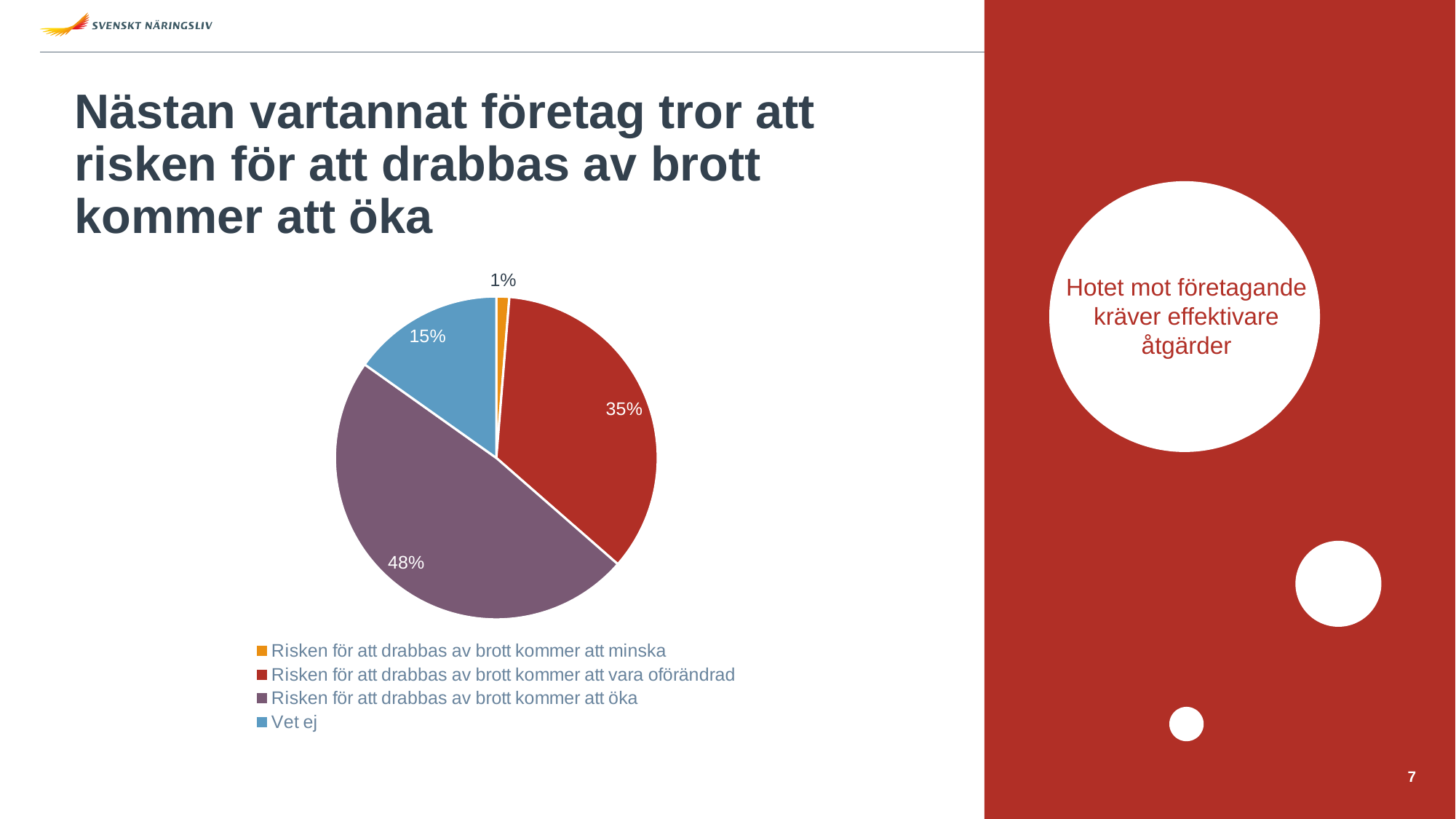
How many slices does the pie chart have? 4 What kind of chart is shown on the slide? pie chart What share of the pie is 'Vet ej'? 15% What share of the pie is 'Risken för att drabbas av brott kommer att minska'? 1% Which is larger: the share for 'Vet ej' or the share for 'Risken för att drabbas av brott kommer att vara oförändrad'? Risken för att drabbas av brott kommer att vara oförändrad What is the difference in percentage points between 'Risken för att drabbas av brott kommer att öka' and 'Risken för att drabbas av brott kommer att vara oförändrad'? 13 percentage points How many entries does the legend list? 4 Which category has the largest slice of the pie? Risken för att drabbas av brott kommer att öka What share of the pie is 'Risken för att drabbas av brott kommer att vara oförändrad'? 35% Which category has the smallest slice of the pie? Risken för att drabbas av brott kommer att minska What colour is the slice for 'Vet ej'? blue